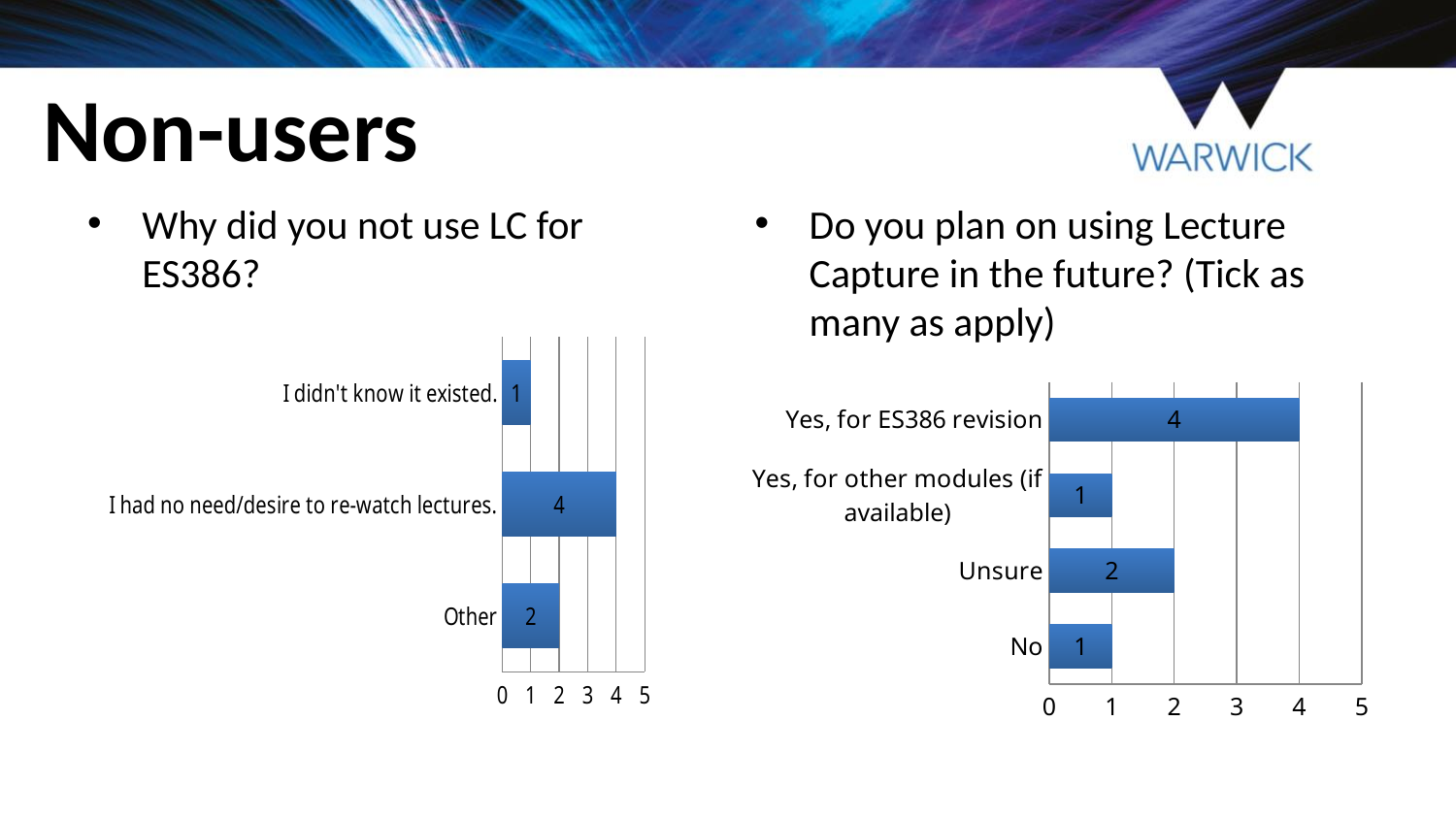
In the left chart (Why did you not use LC for ES386?), what is the difference between "I had no need/desire to re-watch lectures." and "Other"? 2 In the left chart (Why did you not use LC for ES386?), which category has the highest value? I had no need/desire to re-watch lectures. In the right chart (Do you plan on using Lecture Capture in the future?), which category has the highest value? Yes, for ES386 revision In the right chart (Do you plan on using Lecture Capture in the future?), what is the value for "Yes, for ES386 revision"? 4 In the right chart (Do you plan on using Lecture Capture in the future?), what is the value for "Unsure"? 2 In the right chart (Do you plan on using Lecture Capture in the future?), which is larger: "Unsure" or "No"? Unsure In the left chart (Why did you not use LC for ES386?), how many categories are shown? 3 In the left chart (Why did you not use LC for ES386?), what is the value for "I had no need/desire to re-watch lectures."? 4 In the left chart (Why did you not use LC for ES386?), which category has the lowest value? I didn't know it existed. In the right chart (Do you plan on using Lecture Capture in the future?), how many categories are shown? 4 What kind of chart is the right chart (Do you plan on using Lecture Capture in the future?)? Bar chart In the left chart (Why did you not use LC for ES386?), what is the value for "Other"? 2